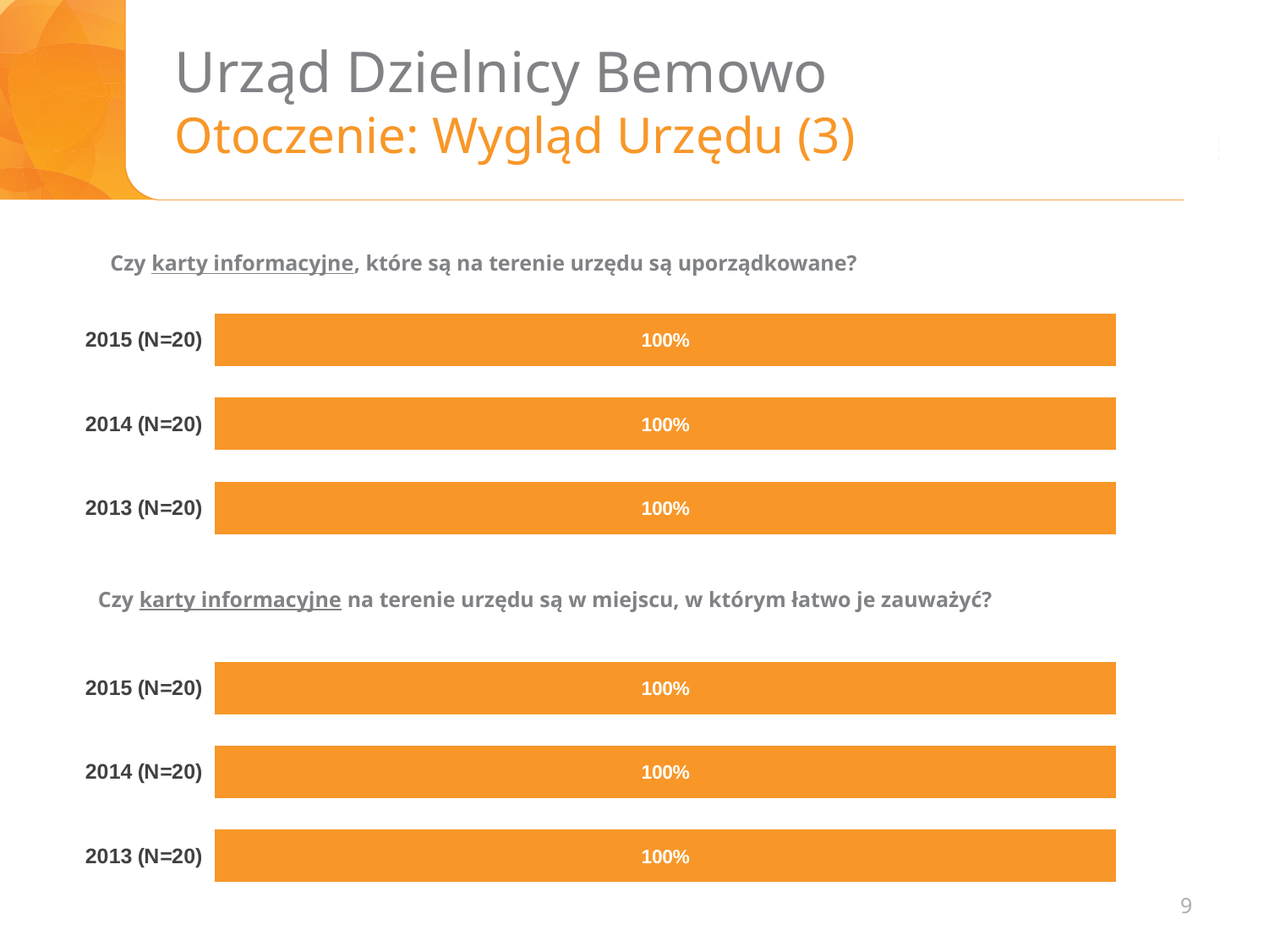
In the top chart ("Czy karty informacyjne, które są na terenie urzędu są uporządkowane?"), what is the value for 2015 (N=20)? 100% In the bottom chart ("Czy karty informacyjne na terenie urzędu są w miejscu, w którym łatwo je zauważyć?"), do the values change between 2013 (N=20) and 2015 (N=20)? No, they stay at 100% How many bars does the top chart ("Czy karty informacyjne, które są na terenie urzędu są uporządkowane?") show? 3 How many bars does the bottom chart ("Czy karty informacyjne na terenie urzędu są w miejscu, w którym łatwo je zauważyć?") show? 3 What is the sample size (N) shown for each year in the top chart ("Czy karty informacyjne, które są na terenie urzędu są uporządkowane?")? N=20 In the top chart ("Czy karty informacyjne, które są na terenie urzędu są uporządkowane?"), what is the value for 2013 (N=20)? 100% In the bottom chart ("Czy karty informacyjne na terenie urzędu są w miejscu, w którym łatwo je zauważyć?"), what is the value for 2015 (N=20)? 100% In the bottom chart ("Czy karty informacyjne na terenie urzędu są w miejscu, w którym łatwo je zauważyć?"), what is the value for 2014 (N=20)? 100% What kind of chart is the top chart ("Czy karty informacyjne, które są na terenie urzędu są uporządkowane?")? Bar chart In the top chart ("Czy karty informacyjne, które są na terenie urzędu są uporządkowane?"), what is the difference between the values for 2015 (N=20) and 2013 (N=20)? 0% What colour are the bars in the bottom chart ("Czy karty informacyjne na terenie urzędu są w miejscu, w którym łatwo je zauważyć?")? Orange